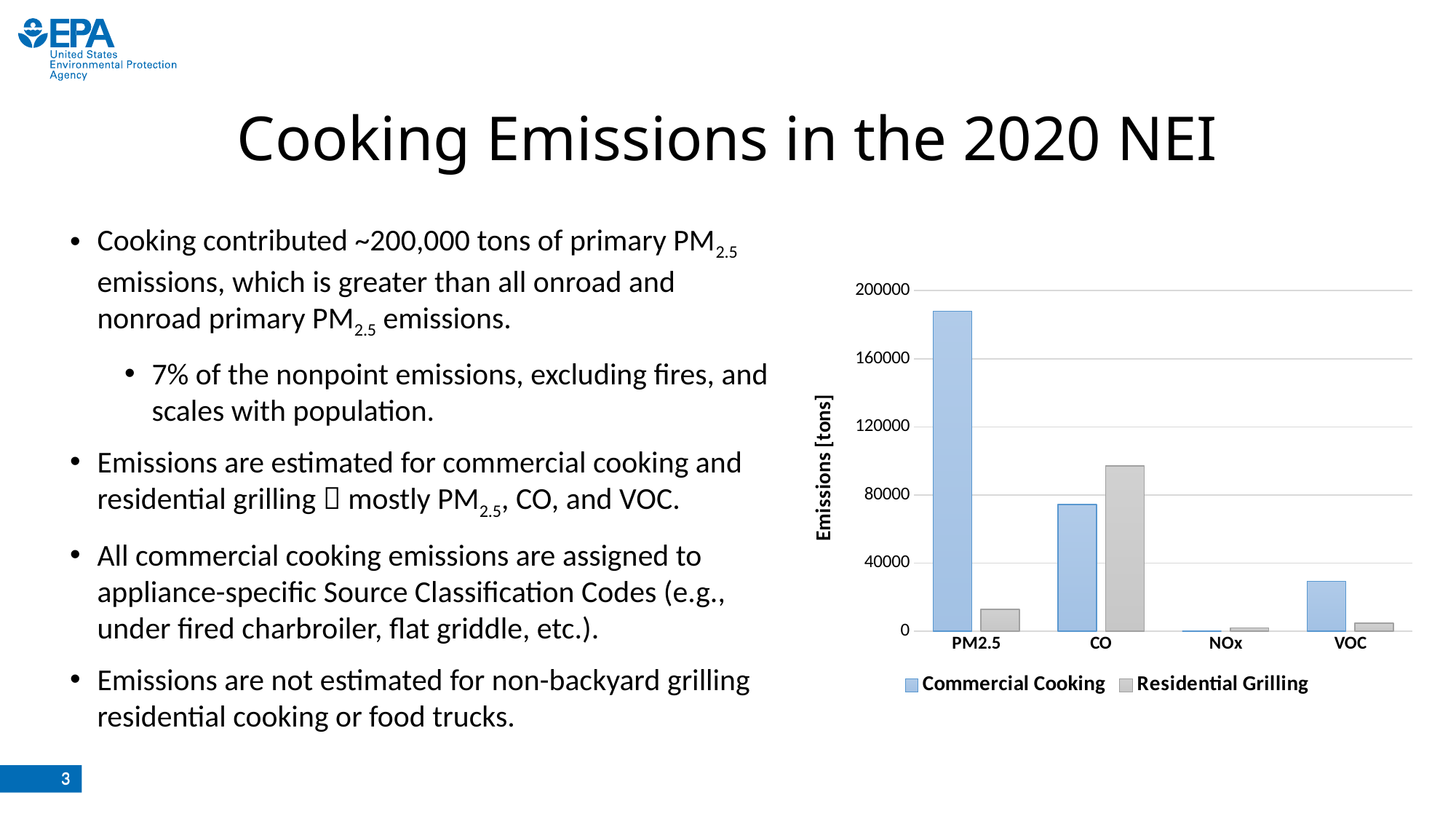
For CO, which series has the larger emissions, Commercial Cooking or Residential Grilling? Residential Grilling How many pollutant categories are shown on the x axis of the chart? 4 Which pollutant has the lowest Commercial Cooking emissions? NOx Which pollutant has the highest Commercial Cooking emissions? PM2.5 What kind of chart is shown on the slide? bar chart For PM2.5, which series has the larger emissions, Commercial Cooking or Residential Grilling? Commercial Cooking Which pollutant has the highest Residential Grilling emissions? CO How many series does the chart legend list? 2 Is the Commercial Cooking value for PM2.5 greater or less than 160000? greater Is the Commercial Cooking value for VOC greater or less than 40000? less What is the label on the y axis of the chart? Emissions [tons] Is the Residential Grilling value for CO greater or less than 80000? greater